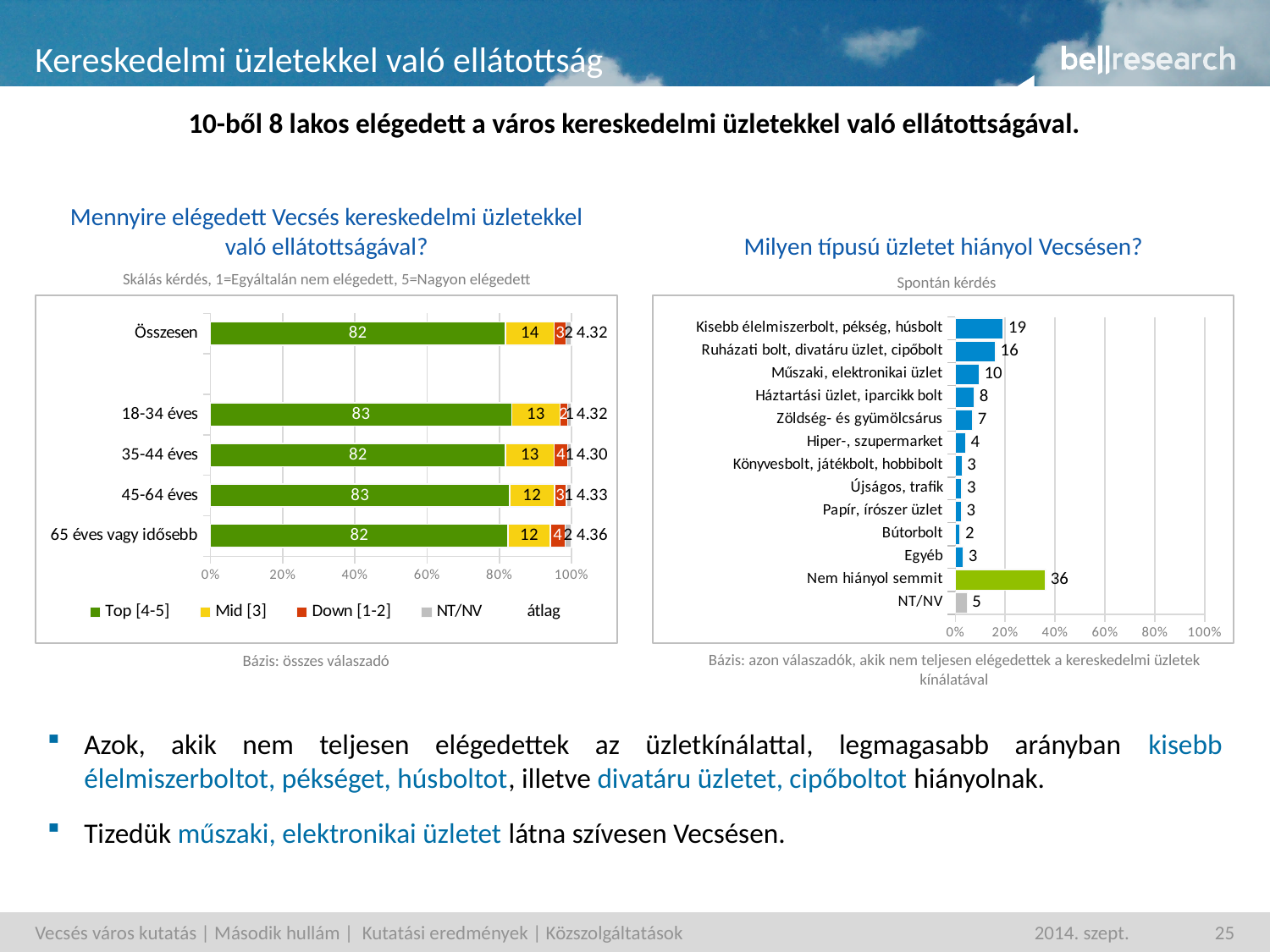
How many categories are shown in the right chart 'Milyen típusú üzletet hiányol Vecsésen?'? 13 In the left chart 'Mennyire elégedett Vecsés kereskedelmi üzletekkel való ellátottságával?', what is the Mid [3] value for 'Összesen'? 14 In the right chart 'Milyen típusú üzletet hiányol Vecsésen?', what is the value for 'Kisebb élelmiszerbolt, pékség, húsbolt'? 19 In the left chart 'Mennyire elégedett Vecsés kereskedelmi üzletekkel való ellátottságával?', what is the Top [4-5] value for '18-34 éves'? 83 In the right chart 'Milyen típusú üzletet hiányol Vecsésen?', which category has the highest value? Nem hiányol semmit In the right chart 'Milyen típusú üzletet hiányol Vecsésen?', which category has the lowest value? Bútorbolt In the right chart 'Milyen típusú üzletet hiányol Vecsésen?', what is the value for 'Műszaki, elektronikai üzlet'? 10 In the right chart 'Milyen típusú üzletet hiányol Vecsésen?', what is the difference between 'Kisebb élelmiszerbolt, pékség, húsbolt' and 'Ruházati bolt, divatáru üzlet, cipőbolt'? 3 In the right chart 'Milyen típusú üzletet hiányol Vecsésen?', is the value for 'Nem hiányol semmit' greater or less than 20%? greater In the right chart 'Milyen típusú üzletet hiányol Vecsésen?', which is larger: 'Műszaki, elektronikai üzlet' or 'Háztartási üzlet, iparcikk bolt'? Műszaki, elektronikai üzlet In the left chart 'Mennyire elégedett Vecsés kereskedelmi üzletekkel való ellátottságával?', what is the átlag (average) for '65 éves vagy idősebb'? 4.36 What type of chart is the left chart 'Mennyire elégedett Vecsés kereskedelmi üzletekkel való ellátottságával?'? Stacked bar chart